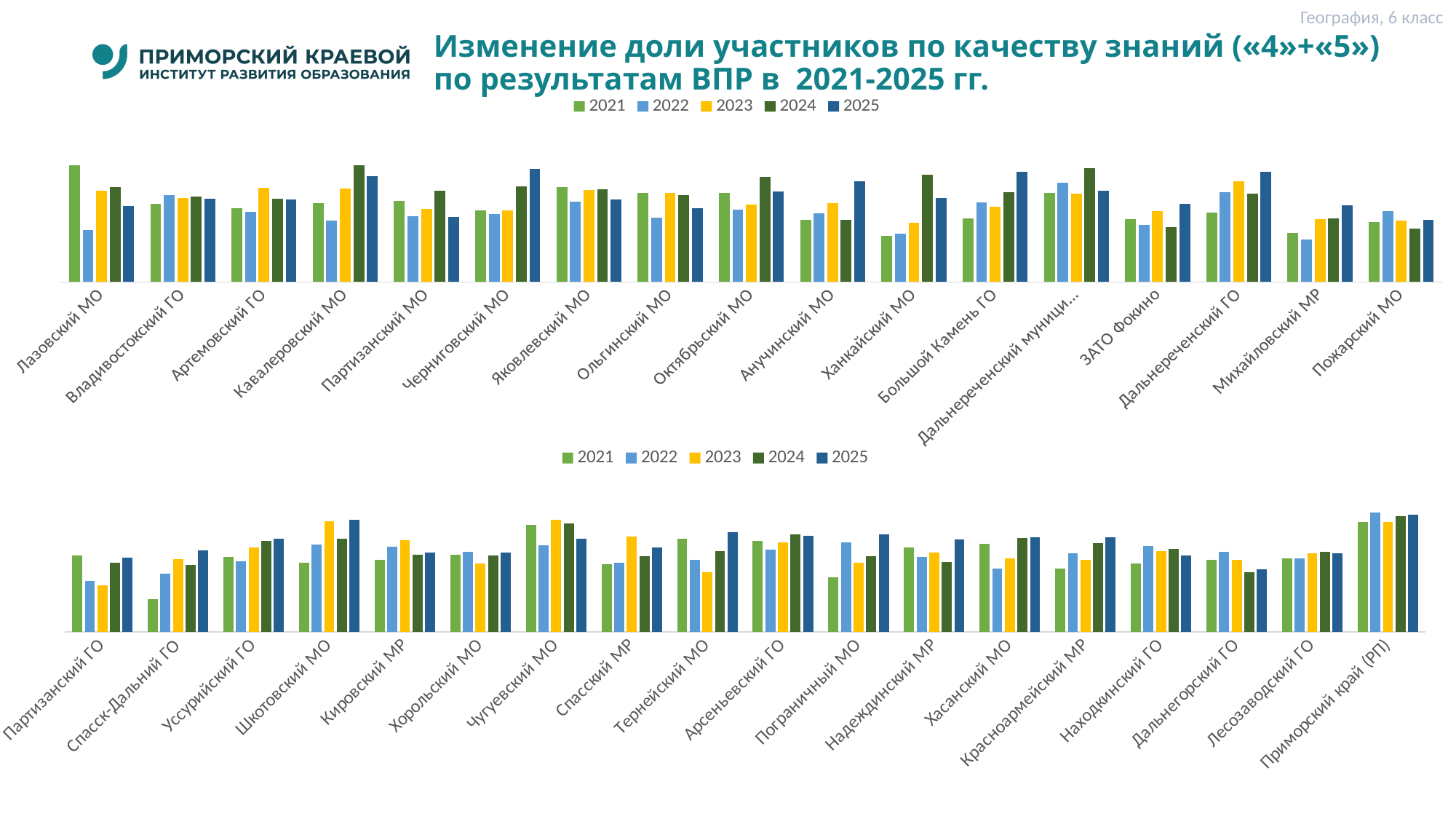
How many series does the legend of the top chart list? 5 In the top chart, which year has the lowest bar for Лазовский МО? 2022 In the top chart, which year has the highest bar for Черниговский МО? 2025 What kind of chart is the top chart on the slide? bar chart In the top chart, which year has the highest bar for Ханкайский МО? 2024 In the top chart, which is larger for Кавалеровский МО: the 2022 bar or the 2024 bar? 2024 How many categories are shown on the x axis of the bottom chart? 18 In the bottom chart, which year has the lowest bar for Пограничный МО? 2021 In the top chart, which year has the highest bar for Лазовский МО? 2021 How many categories are shown on the x axis of the top chart? 17 In the bottom chart, which year has the lowest bar for Спасск-Дальний ГО? 2021 Which year is shown in yellow in the legend of the charts? 2023